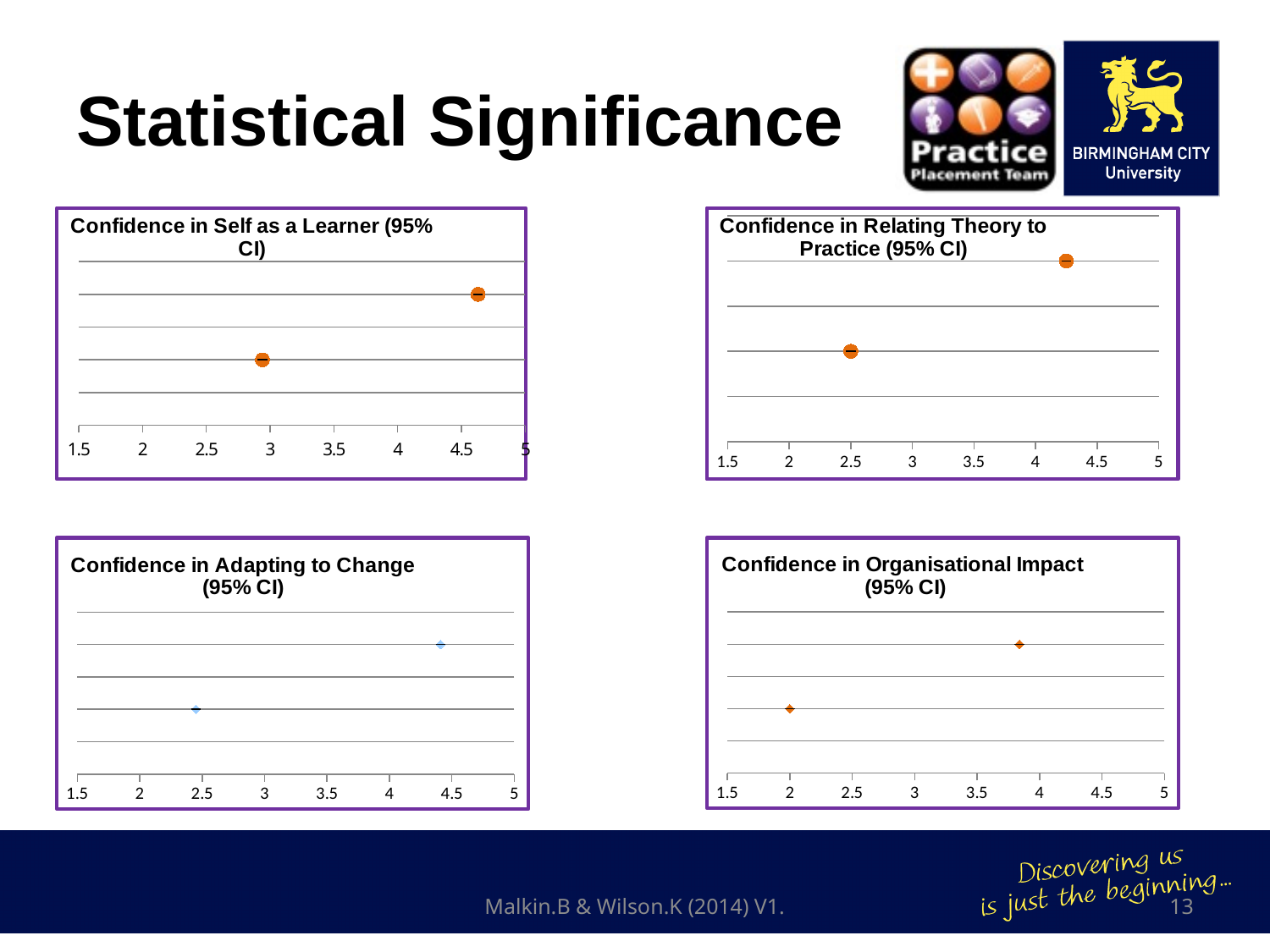
In the 'Confidence in Relating Theory to Practice (95% CI)' chart, is the value of the upper point greater or less than 4? greater How many data points are plotted in the 'Confidence in Self as a Learner (95% CI)' chart? 2 In the 'Confidence in Adapting to Change (95% CI)' chart, is the value of the upper point greater or less than 4? greater In the 'Confidence in Self as a Learner (95% CI)' chart, is the value of the lower point greater or less than 2.5? greater What kind of chart is the 'Confidence in Adapting to Change (95% CI)' chart? scatter chart In the 'Confidence in Organisational Impact (95% CI)' chart, which point has the larger value, the upper one or the lower one? the upper one What is the highest value shown on the x axis of the 'Confidence in Relating Theory to Practice (95% CI)' chart? 5